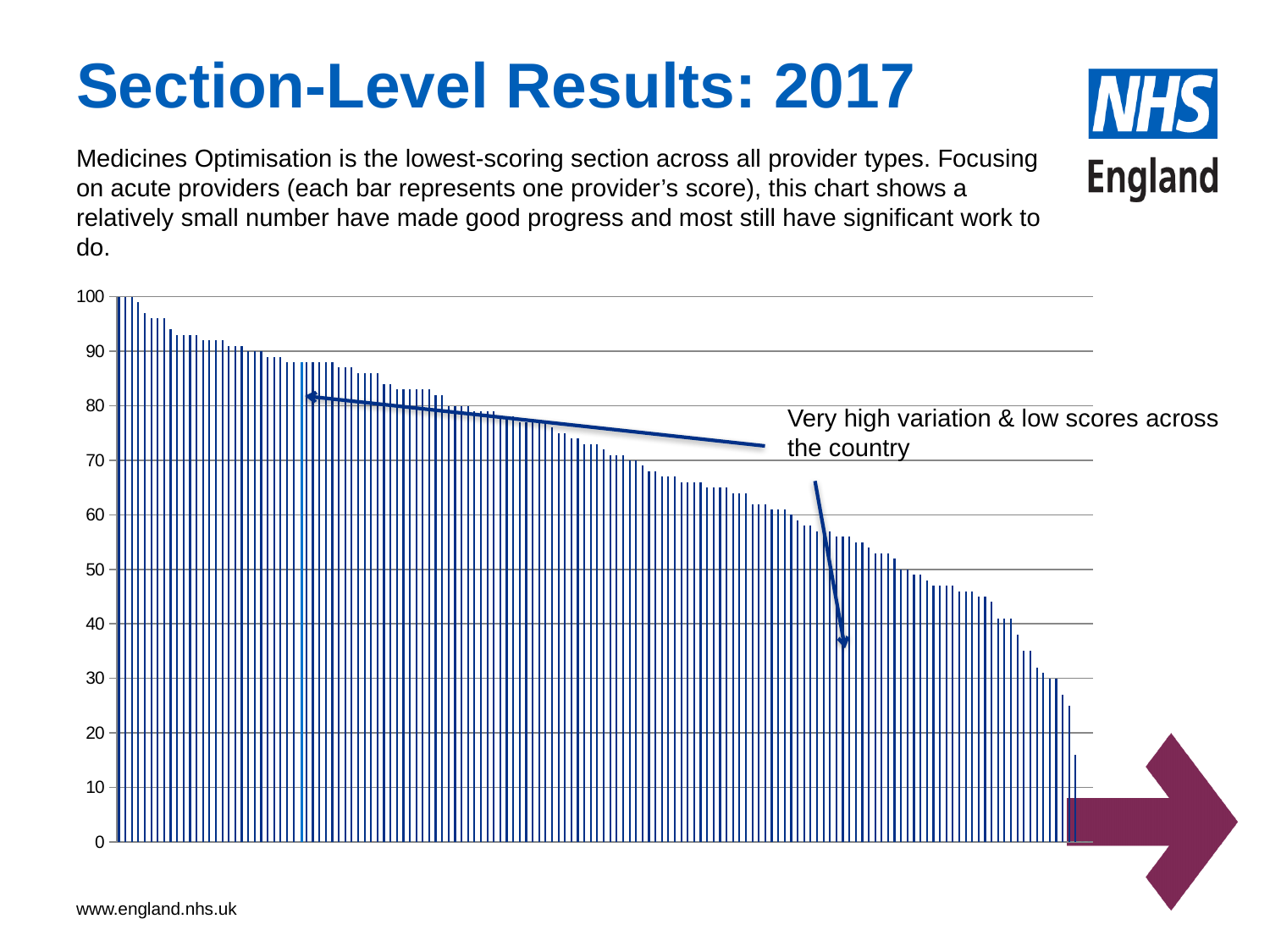
What is the highest value shown on the vertical axis of the chart? 100 Is the value of the leftmost bar in the chart greater or less than 90? greater Do the bar values rise or fall from left to right across the chart? Fall What kind of chart is shown on the slide? Bar chart Which bar is higher: the leftmost bar or the rightmost bar? The leftmost bar What text does the annotation on the chart say? Very high variation & low scores across the country Is the value of the rightmost bar in the chart greater or less than 20? less Is the value of the bar at the far left of the chart greater or less than 50? greater